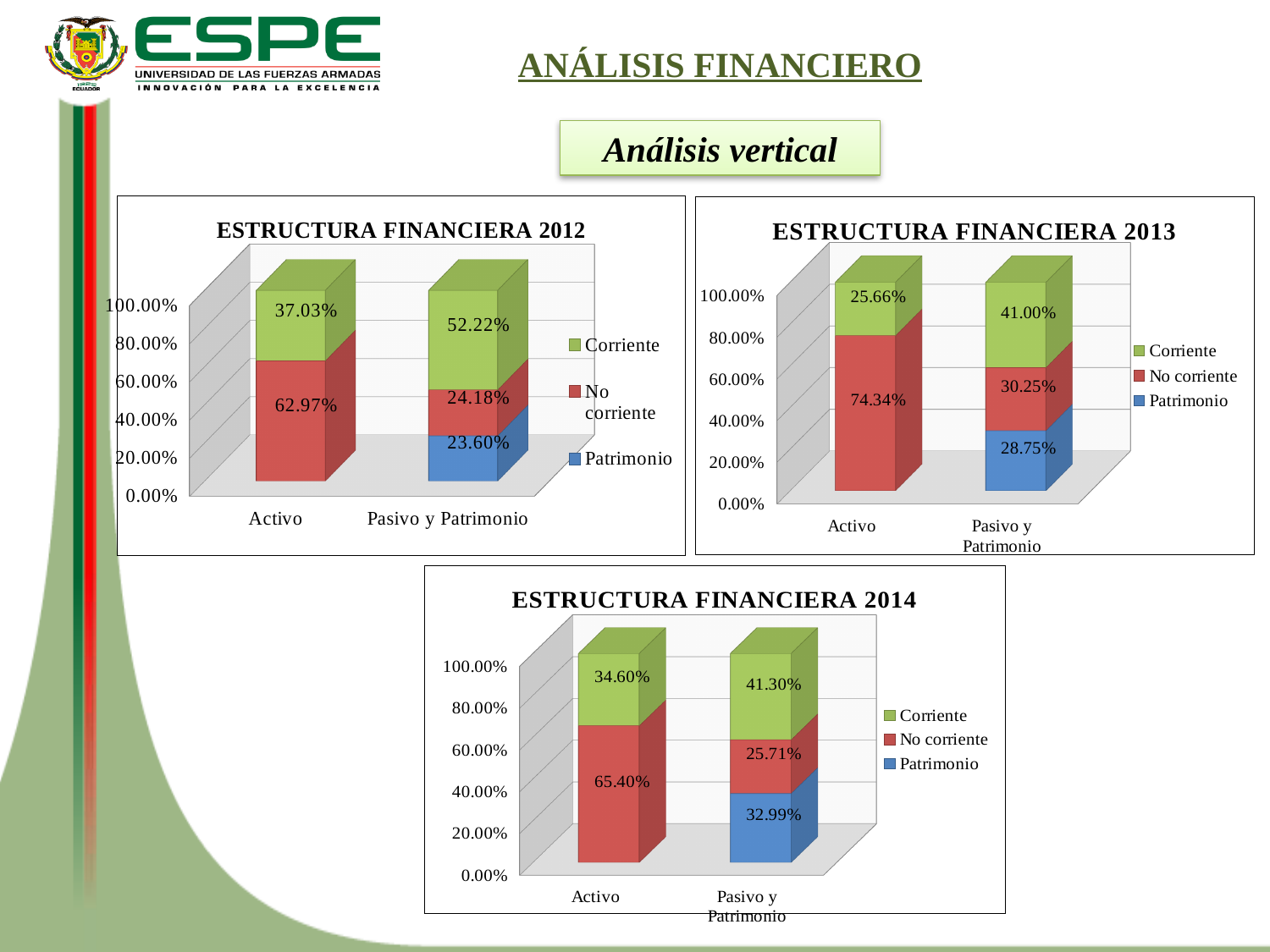
In the ESTRUCTURA FINANCIERA 2014 chart, which is larger for Pasivo y Patrimonio, the Patrimonio value or the No corriente value? Patrimonio In the ESTRUCTURA FINANCIERA 2014 chart, what is the difference between the Patrimonio and No corriente values for Pasivo y Patrimonio? 7.28% In the ESTRUCTURA FINANCIERA 2012 chart, what is the Corriente value for Activo? 37.03% How many series does the legend of the ESTRUCTURA FINANCIERA 2014 chart list? 3 In the ESTRUCTURA FINANCIERA 2013 chart, what is the difference between the No corriente and Corriente values for Activo? 48.68% In the ESTRUCTURA FINANCIERA 2014 chart, what is the Patrimonio value for Pasivo y Patrimonio? 32.99% In the ESTRUCTURA FINANCIERA 2012 chart, what is the total of the Pasivo y Patrimonio stacked bar? 100.00% What kind of chart is the ESTRUCTURA FINANCIERA 2013 chart? Stacked bar chart In the ESTRUCTURA FINANCIERA 2013 chart, what is the No corriente value for Activo? 74.34% In the ESTRUCTURA FINANCIERA 2012 chart, what is the Patrimonio value for Pasivo y Patrimonio? 23.60% In the ESTRUCTURA FINANCIERA 2013 chart, which segment of the Pasivo y Patrimonio bar is the largest? Corriente How many categories are shown on the x axis of the ESTRUCTURA FINANCIERA 2012 chart? 2